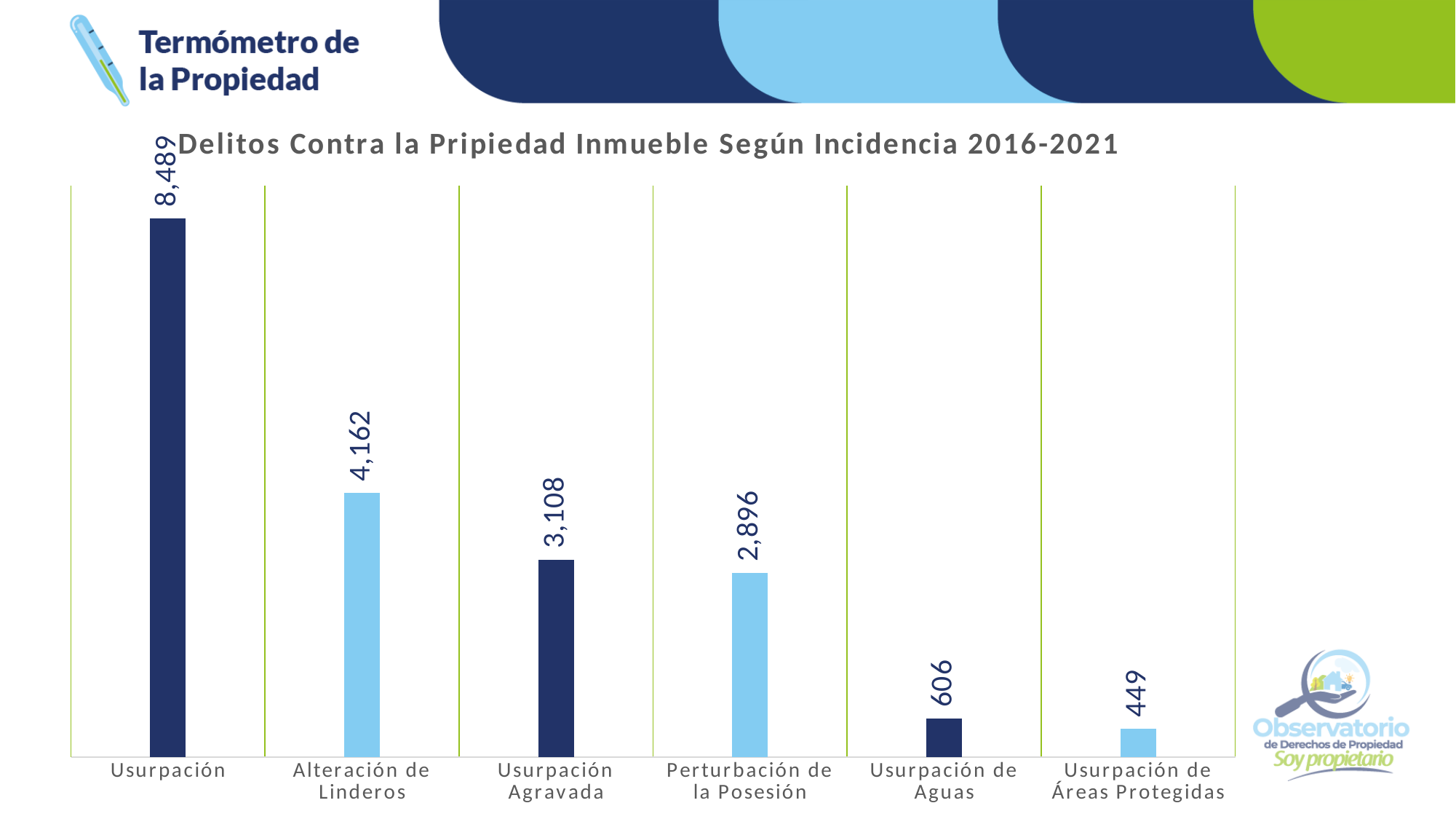
Which category has the lowest value? Usurpación de Áreas Protegidas What is the difference between the values for Usurpación and Alteración de Linderos? 4,327 What is the title of the chart? Delitos Contra la Pripiedad Inmueble Según Incidencia 2016-2021 Which is larger, the value for Usurpación Agravada or the value for Perturbación de la Posesión? Usurpación Agravada What is the value for Alteración de Linderos? 4,162 What is the value for Usurpación? 8,489 What kind of chart is shown on the slide? Bar chart Which category has the highest value? Usurpación What is the value for Usurpación de Áreas Protegidas? 449 What is the value for Perturbación de la Posesión? 2,896 How many categories are shown in the chart? 6 What is the difference between the values for Usurpación de Aguas and Usurpación de Áreas Protegidas? 157